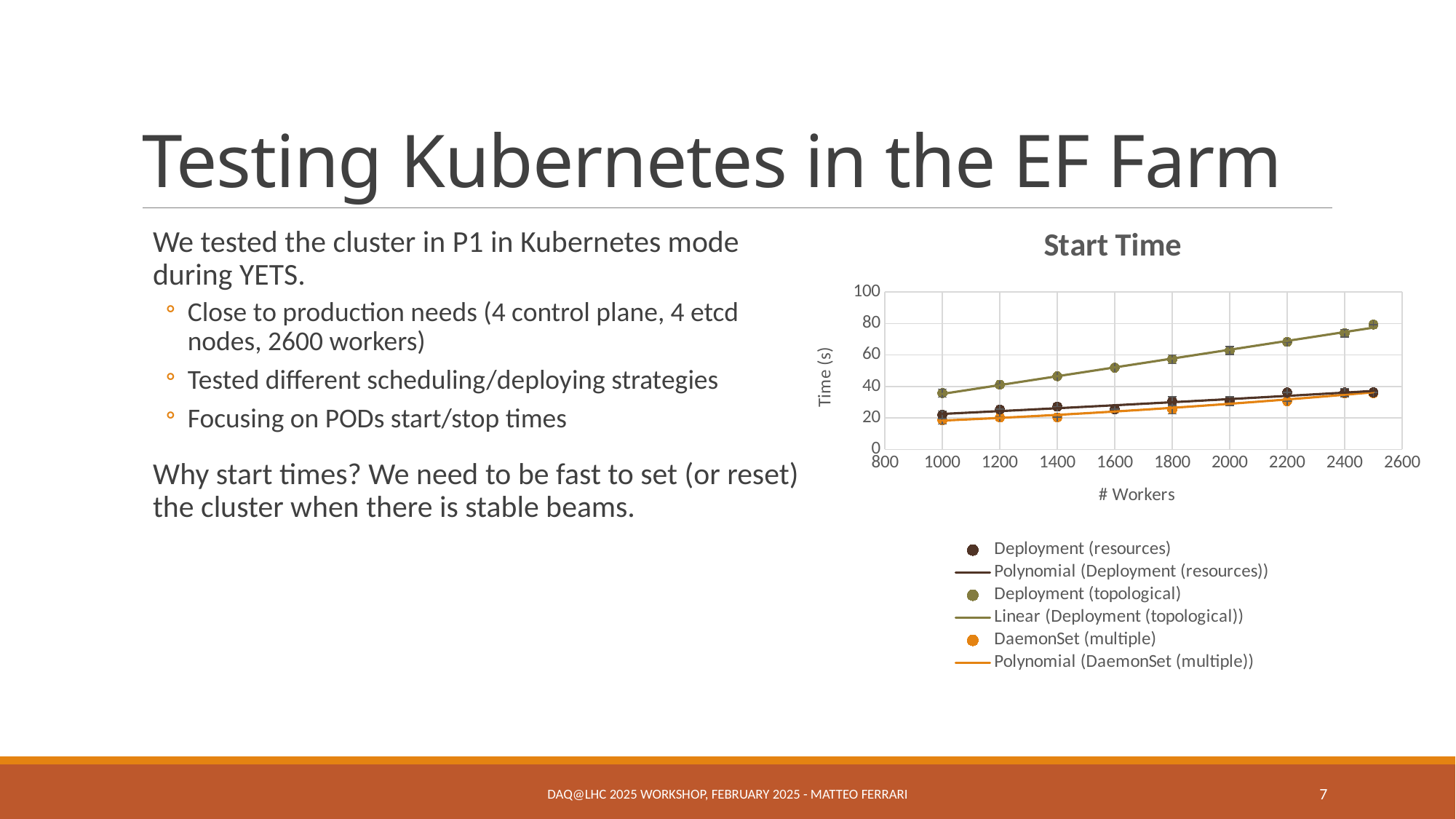
What kind of chart is shown on the slide? scatter chart with trendlines Is the value for Deployment (topological) at 1600 workers greater or less than 40? greater Do the start times rise or fall as the number of workers increases? rise Is the value for Deployment (topological) at 1000 workers greater or less than 40? less Which series has the lowest start time at 1000 workers? DaemonSet (multiple) How many entries does the chart legend list? 6 Is the value for Deployment (topological) at 2500 workers greater or less than 60? greater What is the title of the chart? Start Time What is the label of the y axis of the chart? Time (s) Which series has the highest start time at 2500 workers? Deployment (topological) At 1400 workers, which is larger: Deployment (topological) or DaemonSet (multiple)? Deployment (topological)